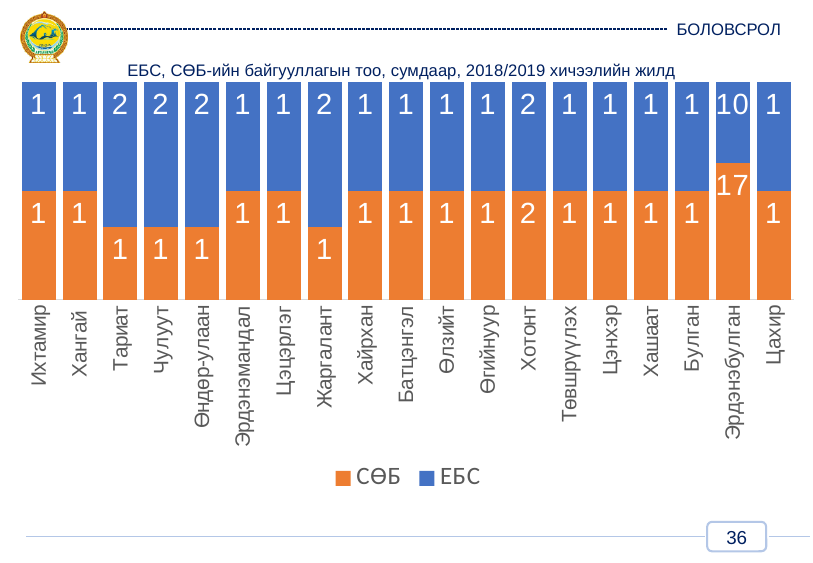
What is the ЕБС value for Эрдэнэбулган? 10 What is the difference between the СӨБ and ЕБС values for Эрдэнэбулган? 7 How many categories (sums) are shown on the x axis? 19 What is the total of the stacked bar for Эрдэнэбулган? 27 Which category has the highest СӨБ value? Эрдэнэбулган What are the two series named in the legend? СӨБ and ЕБС What type of chart is shown on the slide? stacked bar chart What is the СӨБ value for Хотонт? 2 What is the ЕБС value for Тариат? 2 What is the СӨБ value for Эрдэнэбулган? 17 Which is larger for Чулуут, the ЕБС value or the СӨБ value? ЕБС How many series does the legend list? 2